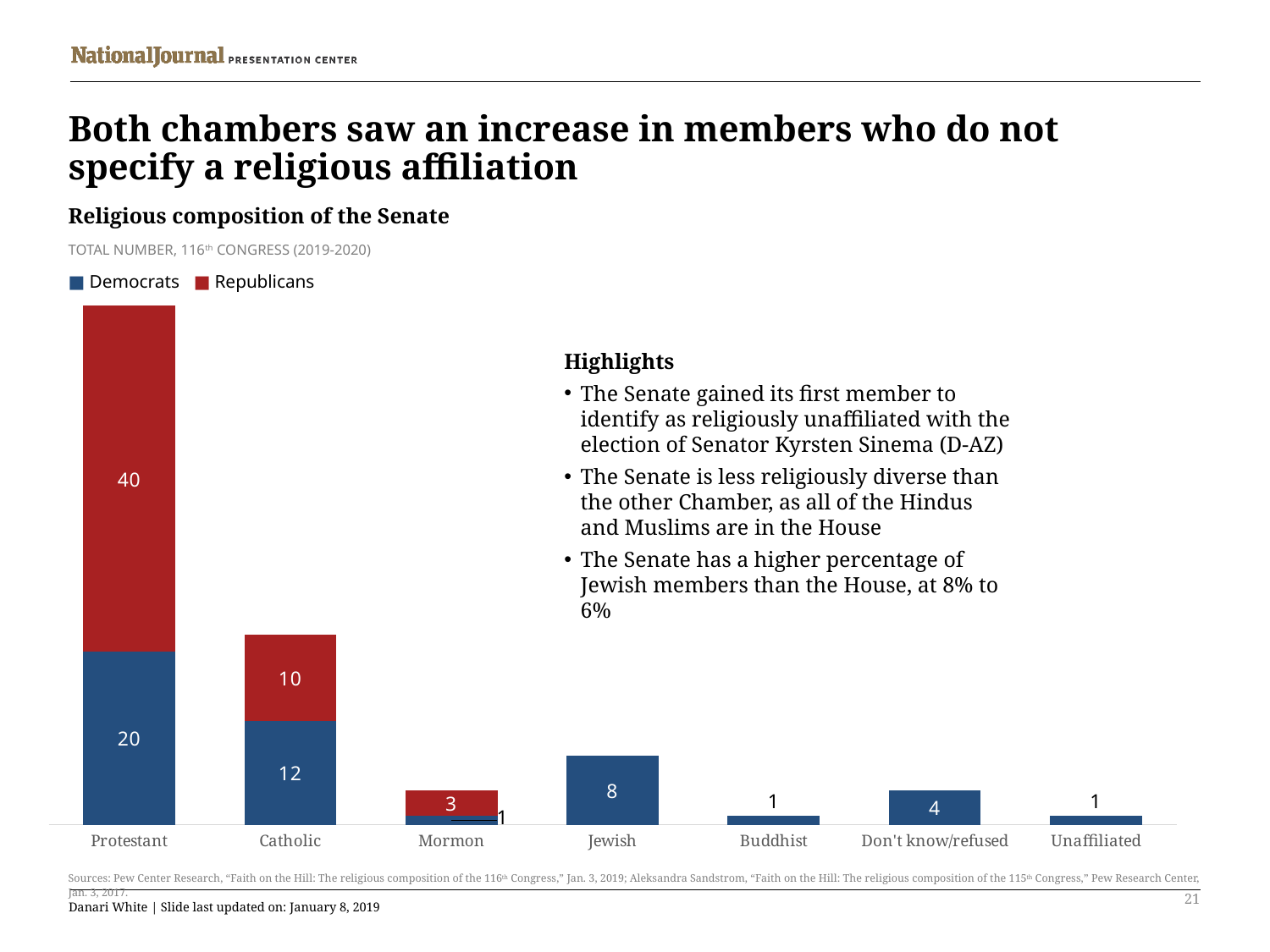
What is the Republicans value for Catholic? 10 What is the Republicans value for Mormon? 3 What kind of chart is shown on the slide? Stacked bar chart What is the difference between the Republicans value and the Democrats value for Protestant? 20 What is the Democrats value for Jewish? 8 What is the total of the stacked bar for Catholic? 22 What is the total of the stacked bar for Protestant? 60 What is the Democrats value for Protestant? 20 Which category has the highest total? Protestant How many categories are shown on the x axis? 7 Which is larger for Catholic, the Democrats value or the Republicans value? Democrats How many series does the legend list? 2